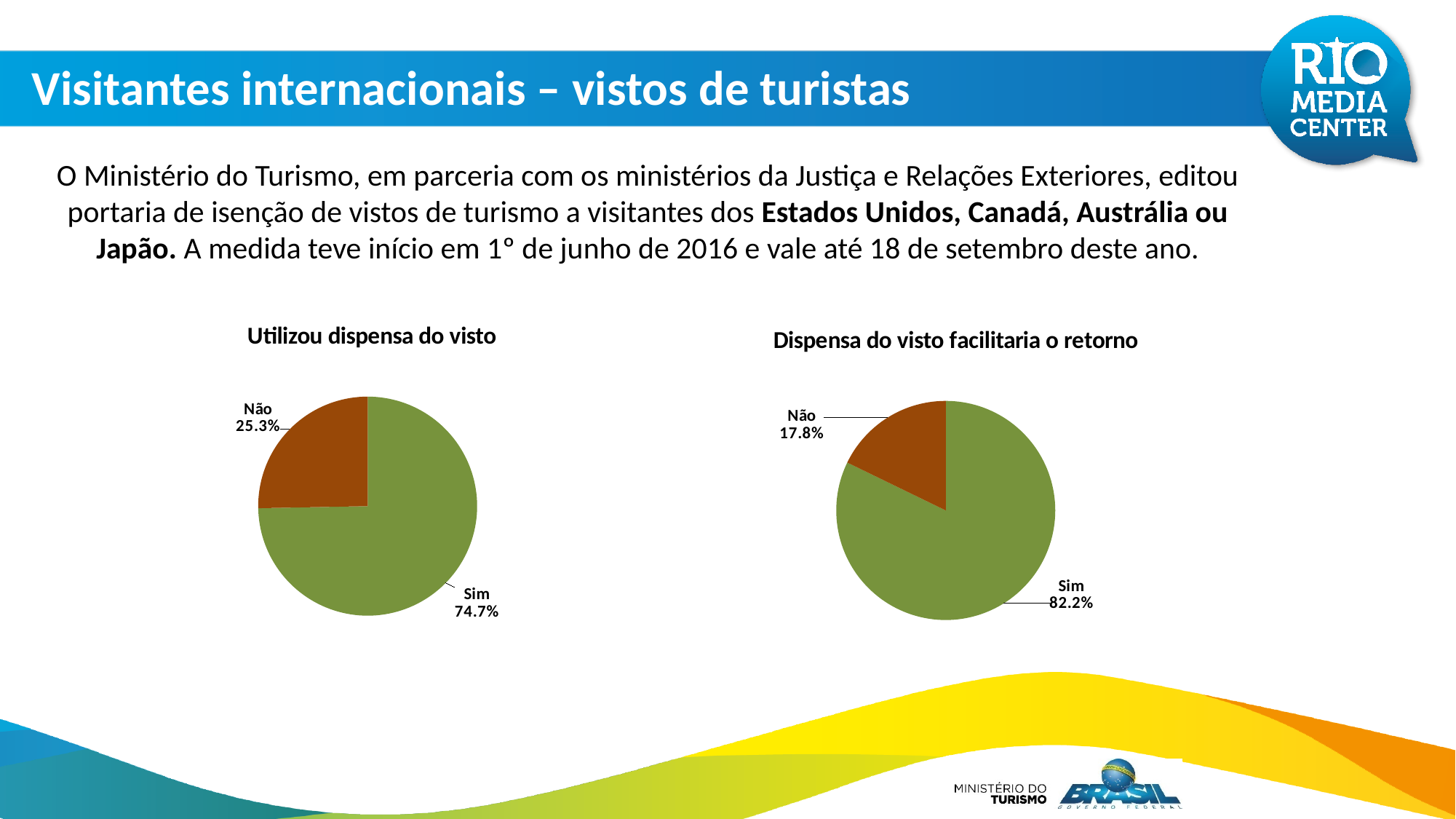
In the chart titled "Utilizou dispensa do visto", what percentage answered "Não"? 25.3% Which chart has the larger "Sim" share: "Utilizou dispensa do visto" or "Dispensa do visto facilitaria o retorno"? Dispensa do visto facilitaria o retorno How many slices does the chart titled "Dispensa do visto facilitaria o retorno" have? 2 In the chart titled "Utilizou dispensa do visto", what is the difference between the "Sim" and "Não" shares? 49.4% In the chart titled "Utilizou dispensa do visto", what colour is the "Não" slice? Brown In the chart titled "Dispensa do visto facilitaria o retorno", what percentage answered "Sim"? 82.2% In the chart titled "Dispensa do visto facilitaria o retorno", what percentage answered "Não"? 17.8% In the chart titled "Utilizou dispensa do visto", what percentage answered "Sim"? 74.7% In the chart titled "Dispensa do visto facilitaria o retorno", which slice is the smallest? Não In the chart titled "Dispensa do visto facilitaria o retorno", what is the difference between the "Sim" and "Não" shares? 64.4% In the chart titled "Utilizou dispensa do visto", which slice is the largest? Sim What type of chart is used for "Utilizou dispensa do visto"? Pie chart